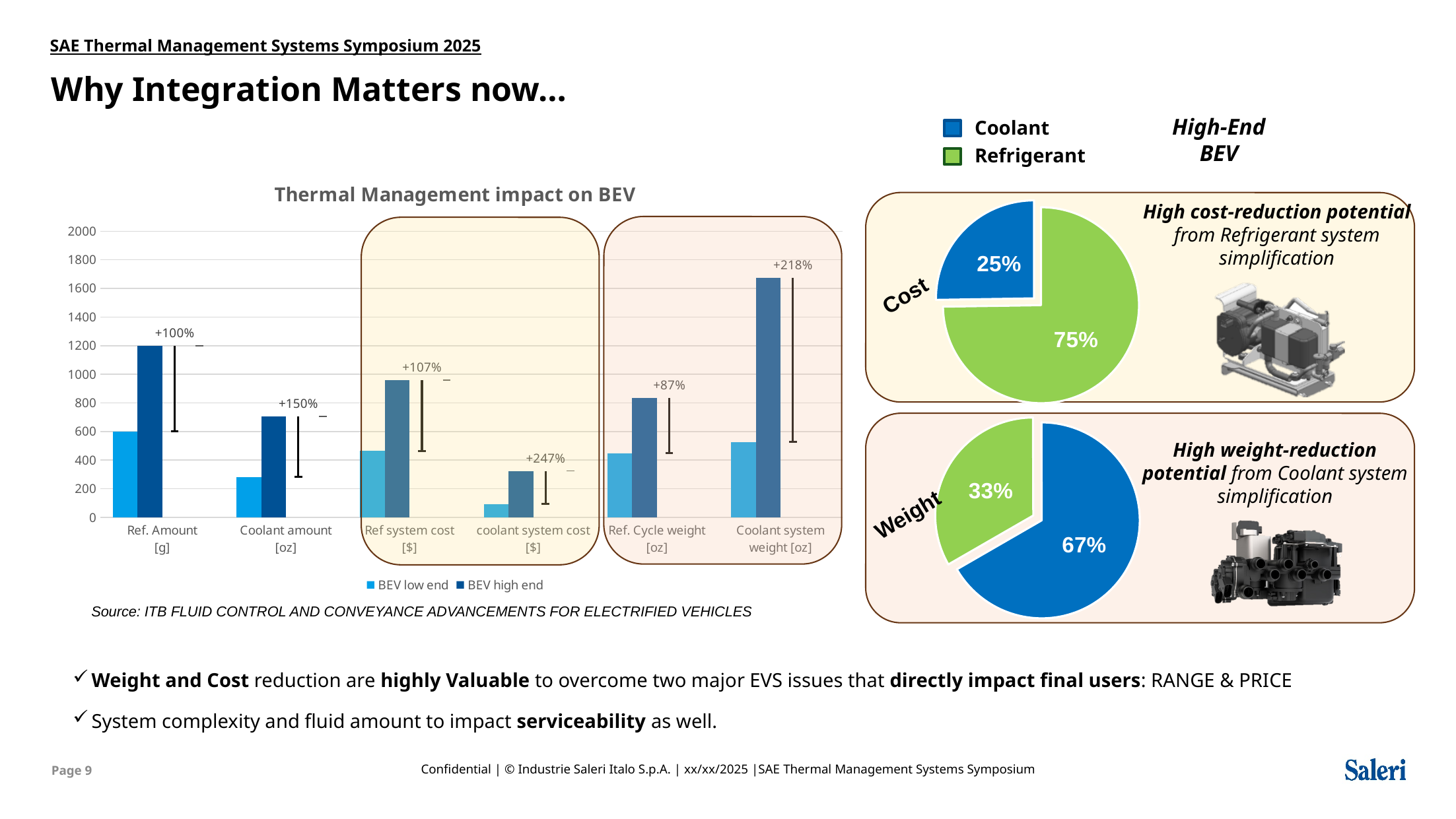
What kind of chart is 'Thermal Management impact on BEV'? bar chart In the 'Thermal Management impact on BEV' chart, what percentage increase is annotated for 'coolant system cost [$]'? +247% In the 'Thermal Management impact on BEV' chart, what percentage increase is annotated for 'Coolant system weight [oz]'? +218% In the 'Thermal Management impact on BEV' chart, which category has the tallest BEV high end bar? Coolant system weight [oz] In the 'Thermal Management impact on BEV' chart, is the BEV low end value for 'coolant system cost [$]' greater or less than 200? less In the 'Thermal Management impact on BEV' chart, how many categories are shown on the x axis? 6 In the 'Cost' pie chart, what share does Refrigerant have? 75% In the 'Thermal Management impact on BEV' chart, is the BEV high end value for 'Coolant system weight [oz]' greater or less than 1400? greater In the 'Thermal Management impact on BEV' chart, how many series does the legend list? 2 In the 'Weight' pie chart, what share does Coolant have? 67% In the 'Thermal Management impact on BEV' chart, which is larger for 'Ref system cost [$]': BEV low end or BEV high end? BEV high end In the 'Thermal Management impact on BEV' chart, what percentage increase is annotated for 'Ref. Cycle weight [oz]'? +87%